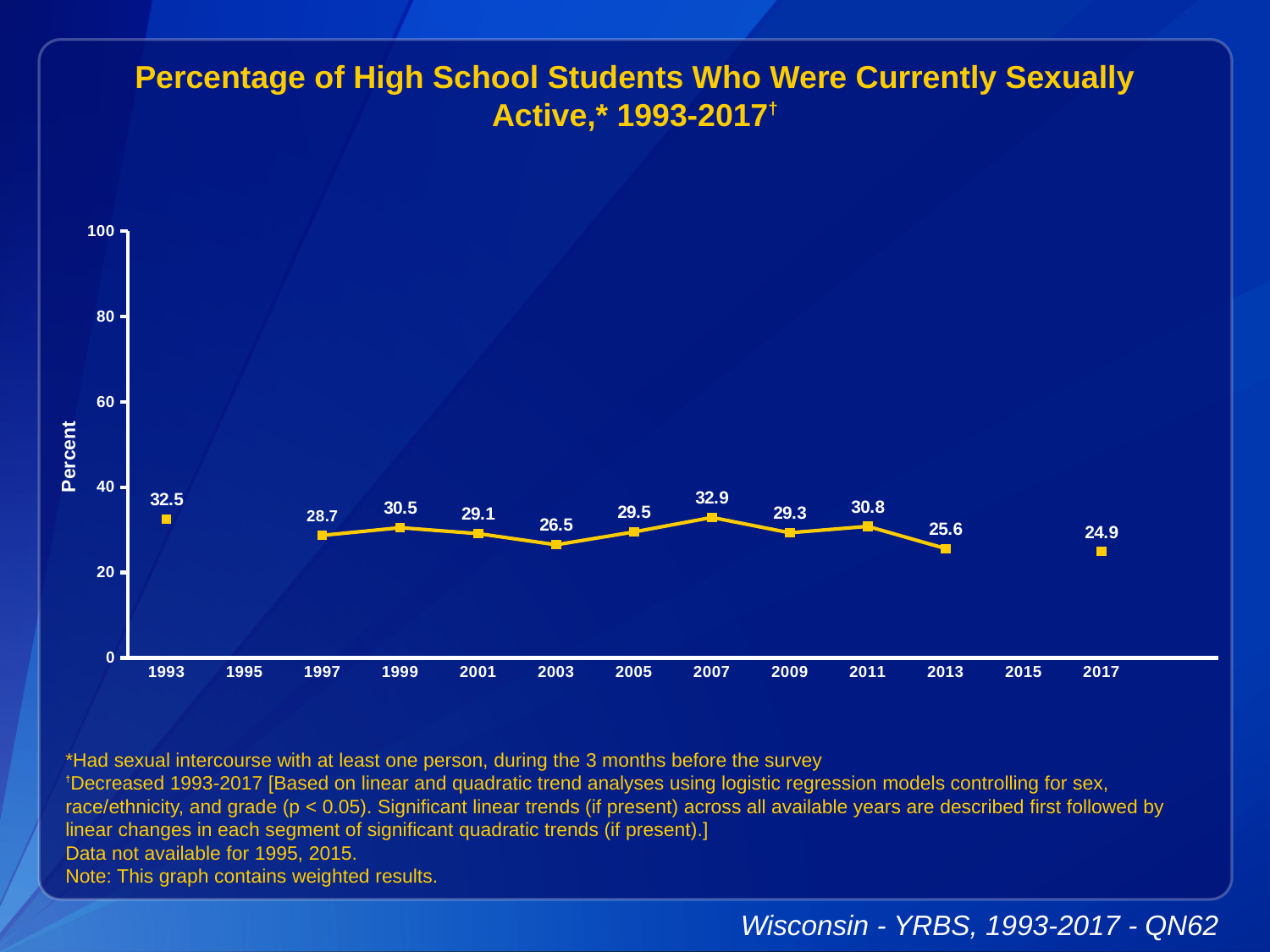
Overall, did the percentage rise or fall from 1993 to 2017? fall Is the value for 2013 greater or less than 40? less How many years have data points plotted on the chart? 11 What was the percentage of high school students who were currently sexually active in 2017? 24.9 Which year has the highest percentage shown on the chart? 2007 What kind of chart is shown on the slide? line chart What value is shown for 2007? 32.9 Which year has the lowest percentage shown on the chart? 2017 Which year has a higher value, 2003 or 2005? 2005 What is the difference between the 1993 value and the 2017 value? 7.6 What is the label on the y axis? Percent What was the percentage of high school students who were currently sexually active in 1993? 32.5